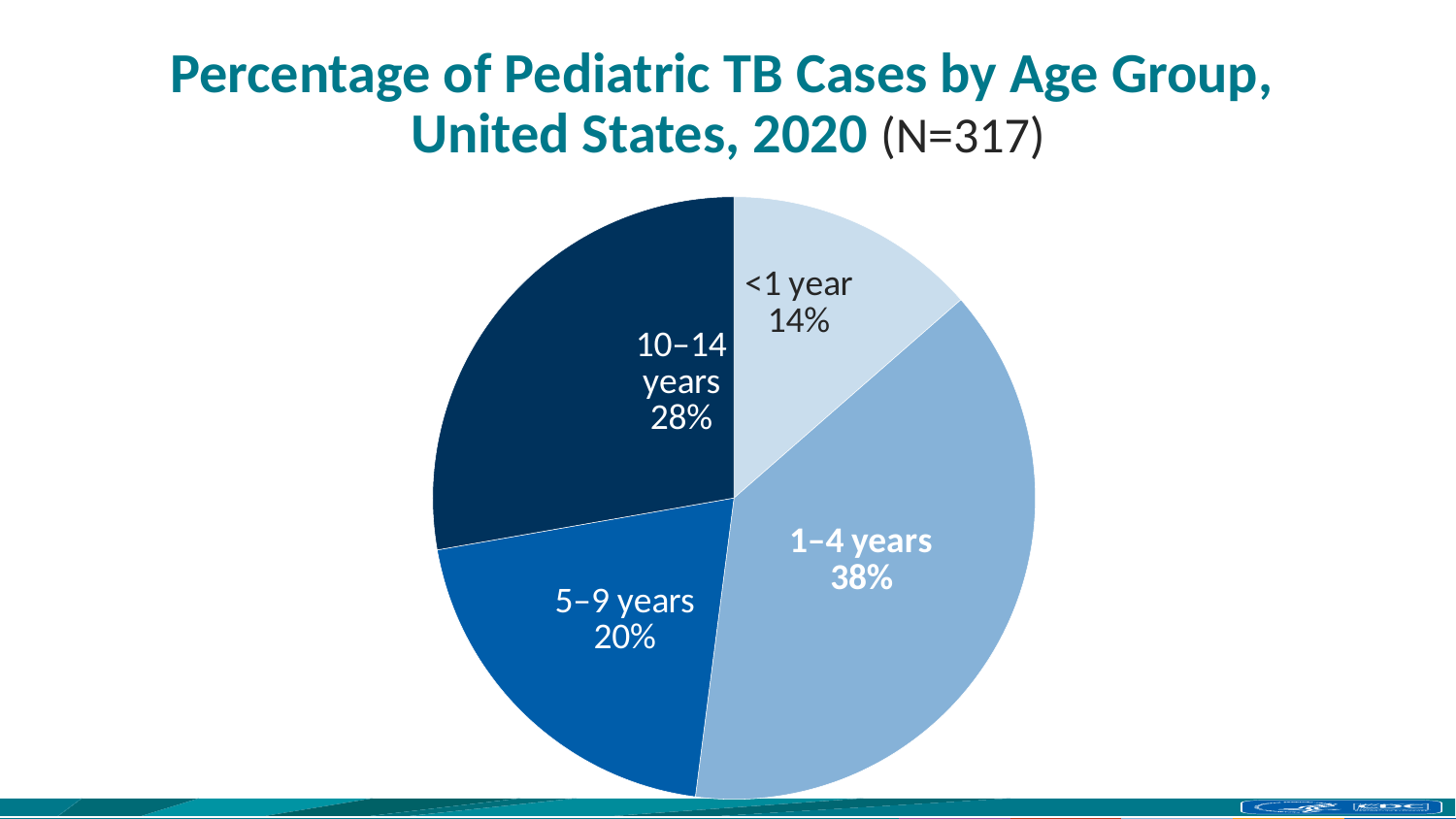
What percentage of pediatric TB cases were in the <1 year age group? 14% What type of chart is shown on the slide? Pie chart Which age group has the smallest share of pediatric TB cases? <1 year What percentage of pediatric TB cases were in the 1–4 years age group? 38% What is the total number of pediatric TB cases (N) stated in the chart title? 317 What is the difference in percentage points between the 1–4 years and 5–9 years age groups? 18 What percentage of pediatric TB cases were in the 10–14 years age group? 28% How many age groups are shown in the pie chart? 4 Which age group has a larger share: 10–14 years or 5–9 years? 10–14 years Which age group has the largest share of pediatric TB cases? 1–4 years What year does the chart title say the data is for? 2020 What percentage of pediatric TB cases were in the 5–9 years age group? 20%